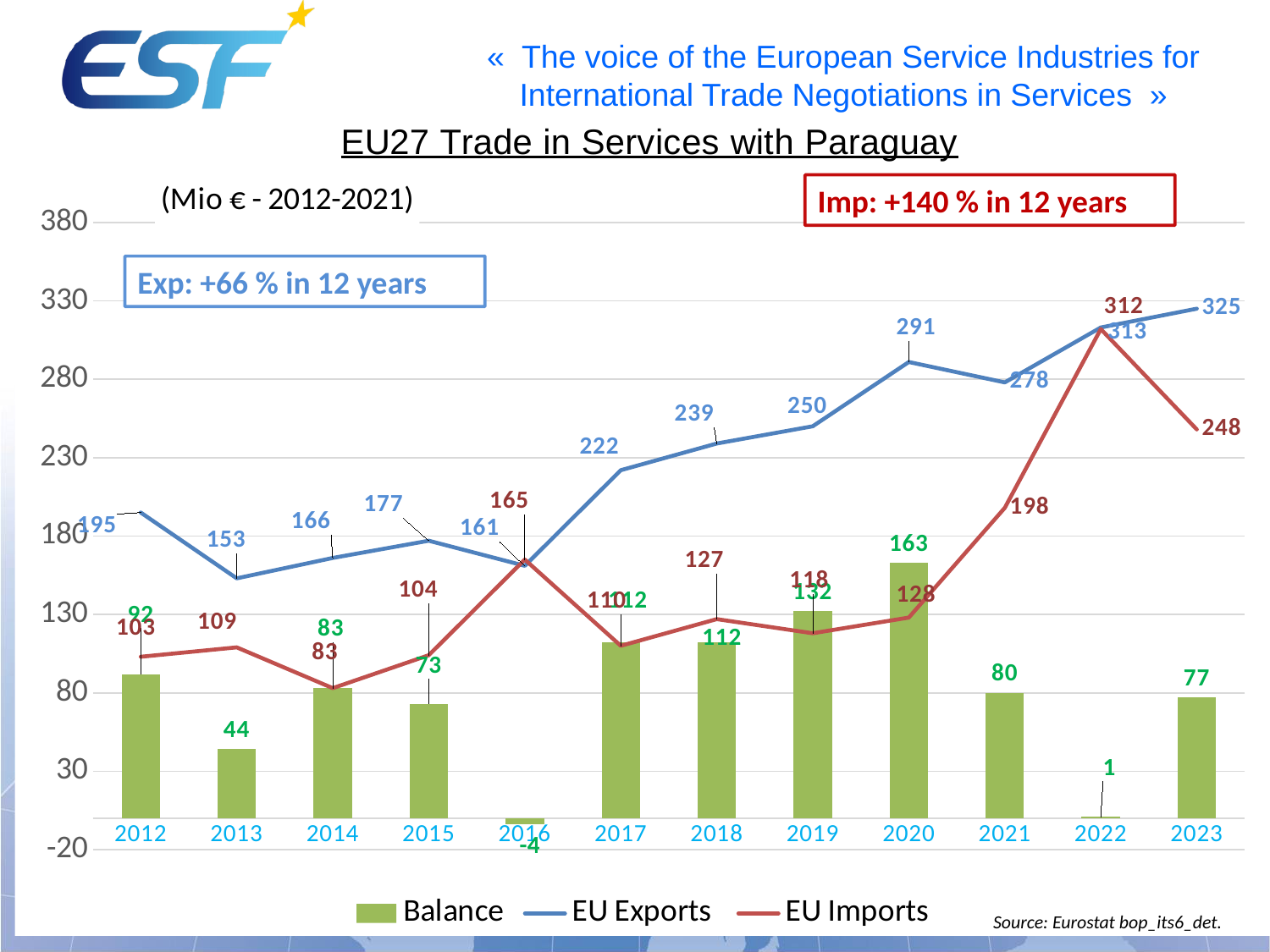
In which year is the Balance highest? 2020 Do EU Imports rise or fall from 2022 to 2023? Fall What is the value of EU Exports in 2020? 291 How many years are shown on the x axis? 12 What kind of chart is this? Combined bar and line chart What is the value of EU Imports in 2021? 198 In which year are EU Exports lowest? 2013 How many series does the legend list? 3 According to the red box, by how much did imports grow in 12 years? +140 % What is the difference between EU Exports and EU Imports in 2023? 77 In 2016, which is larger: EU Exports or EU Imports? EU Imports What is the Balance value in 2016? -4